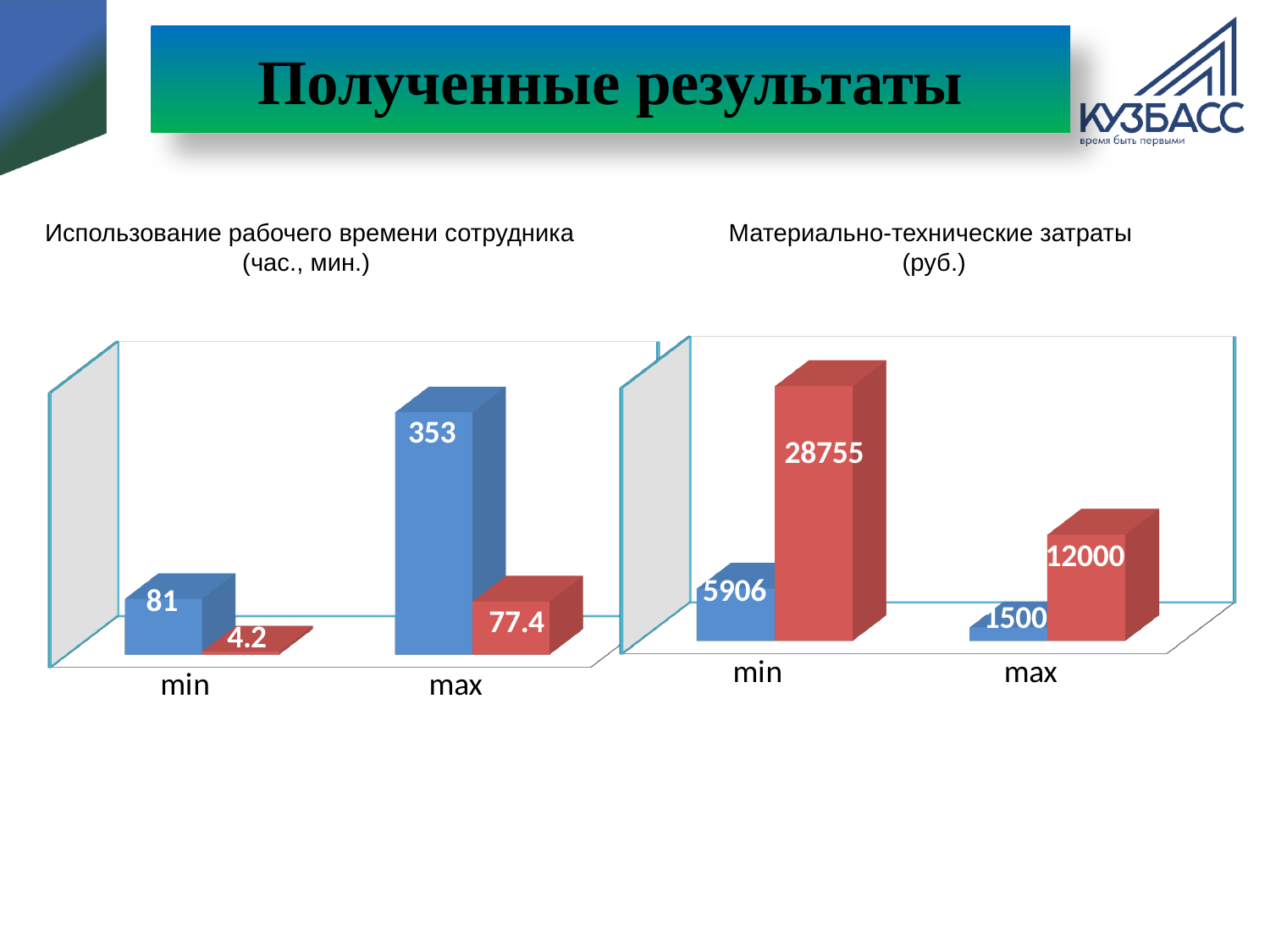
In the right chart (Материально-технические затраты), what is the value of the red bar for min? 28755 In the right chart (Материально-технические затраты), which bar is the tallest? the red bar for min (28755) In the left chart (Использование рабочего времени сотрудника), what is the value of the blue bar for min? 81 In the right chart (Материально-технические затраты), which is larger for min: the blue bar or the red bar? the red bar In the left chart (Использование рабочего времени сотрудника), what is the difference between the blue bars for max and min? 272 In the left chart (Использование рабочего времени сотрудника), what is the value of the red bar for max? 77.4 In the right chart (Материально-технические затраты), what is the difference between the red bars for min and max? 16755 What type of chart is the right chart (Материально-технические затраты)? bar chart In the right chart (Материально-технические затраты), what is the value of the blue bar for max? 1500 How many categories are shown on the x axis of the left chart (Использование рабочего времени сотрудника)? 2 In the left chart (Использование рабочего времени сотрудника), what is the value of the blue bar for max? 353 In the left chart (Использование рабочего времени сотрудника), which bar has the lowest value? the red bar for min (4.2)